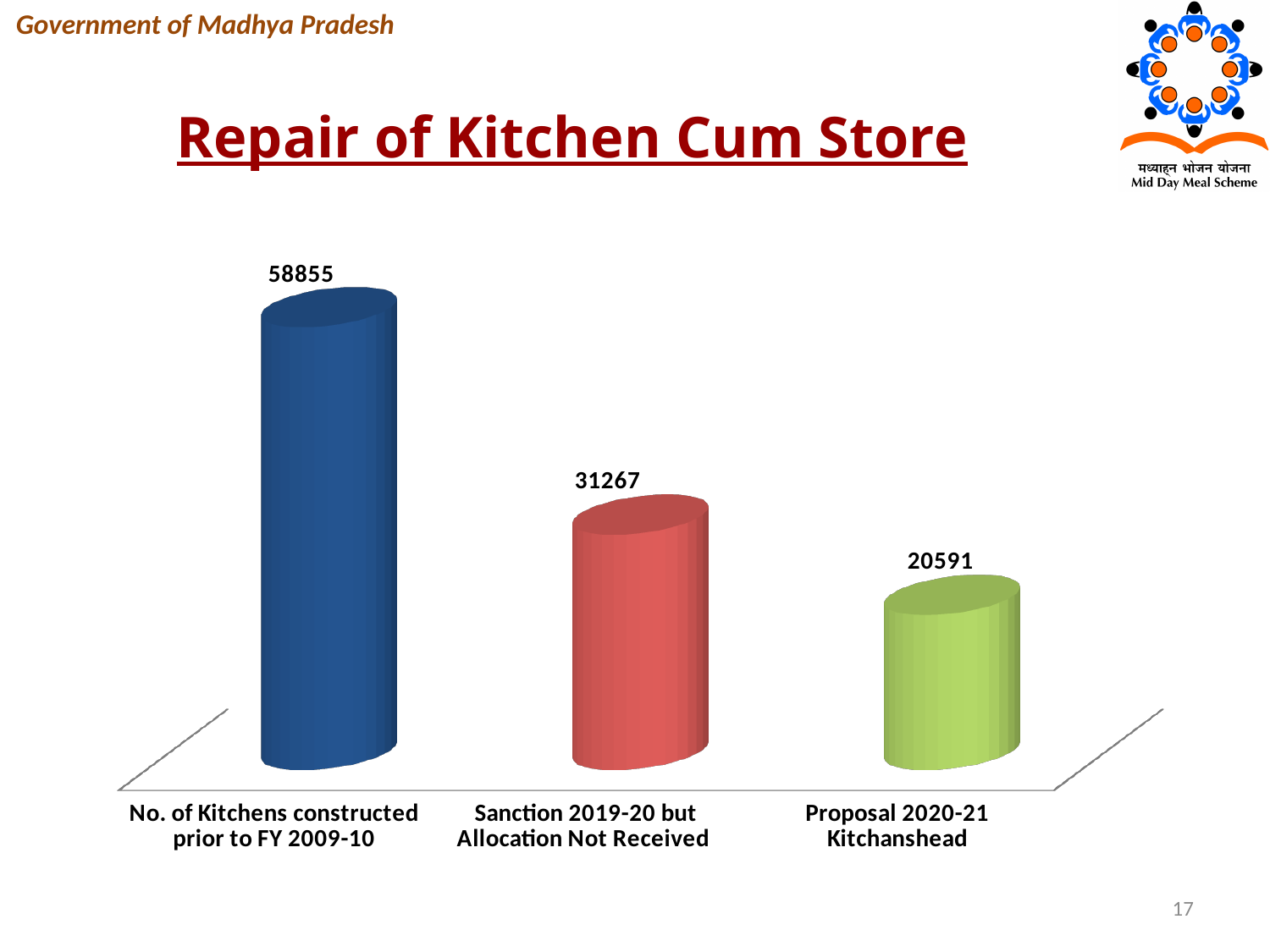
What kind of chart is shown on the slide? Bar chart Do the values rise or fall from left to right across the categories? Fall What is the value for 'No. of Kitchens constructed prior to FY 2009-10'? 58855 What is the value for 'Sanction 2019-20 but Allocation Not Received'? 31267 What is the difference between the values for 'Sanction 2019-20 but Allocation Not Received' and 'Proposal 2020-21 Kitchanshead'? 10676 Which category has the lowest value? Proposal 2020-21 Kitchanshead What is the title of the slide containing the chart? Repair of Kitchen Cum Store How many categories are shown in the chart? 3 Which category has the highest value? No. of Kitchens constructed prior to FY 2009-10 Which is larger: the value for 'Sanction 2019-20 but Allocation Not Received' or the value for 'Proposal 2020-21 Kitchanshead'? Sanction 2019-20 but Allocation Not Received What is the difference between the values for 'No. of Kitchens constructed prior to FY 2009-10' and 'Sanction 2019-20 but Allocation Not Received'? 27588 What is the value for 'Proposal 2020-21 Kitchanshead'? 20591